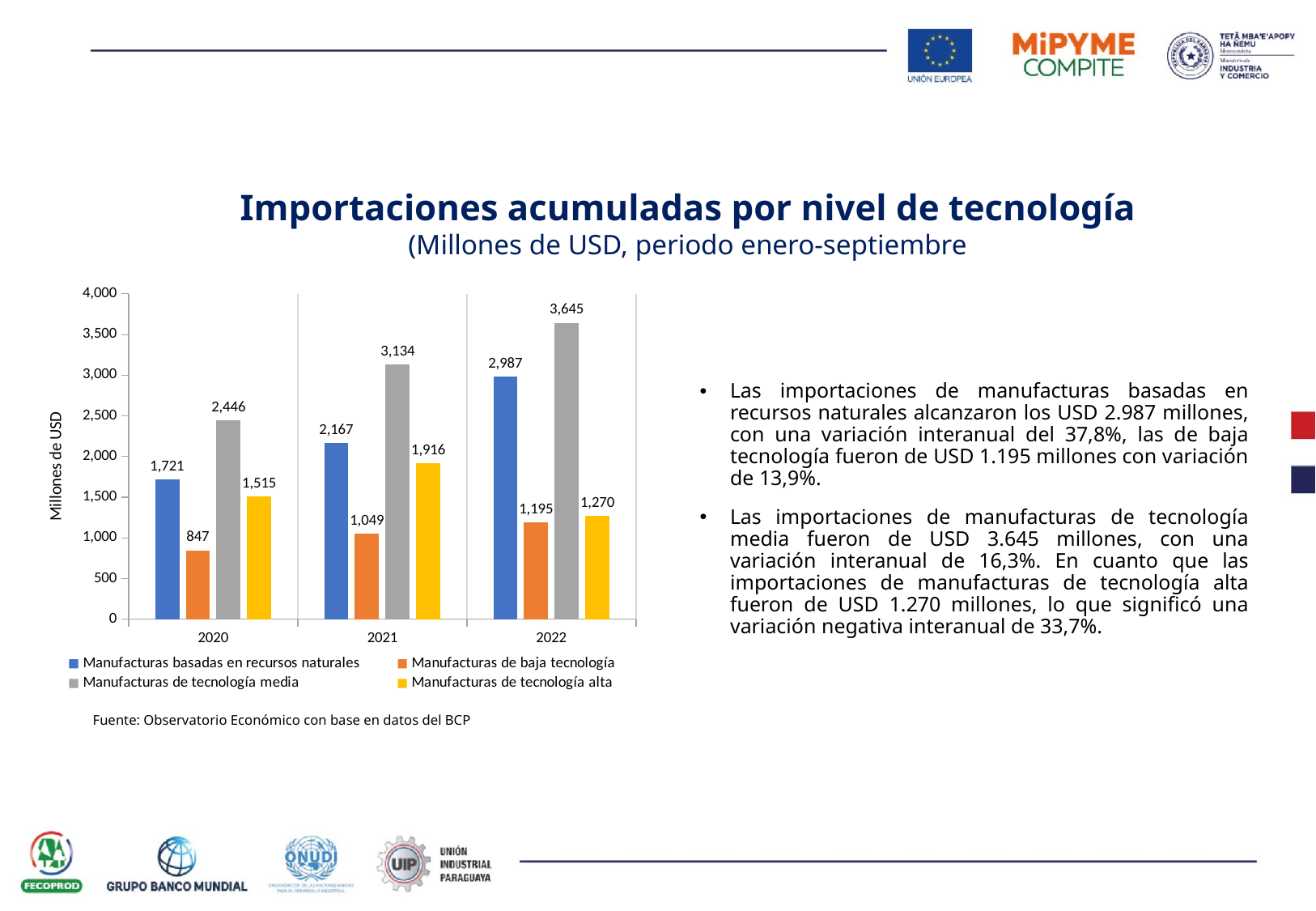
What is the difference between the Manufacturas de tecnología media values in 2022 and 2021? 511 Do the values for Manufacturas basadas en recursos naturales rise or fall from 2020 to 2022? Rise Which is larger in 2022: Manufacturas de tecnología alta or Manufacturas de baja tecnología? Manufacturas de tecnología alta In which year is the value for Manufacturas de tecnología media highest? 2022 What kind of chart is shown on the slide? Bar chart How many series does the legend list? 4 What is the value for Manufacturas de tecnología media in 2022? 3,645 What is the value for Manufacturas basadas en recursos naturales in 2021? 2,167 What is the value for Manufacturas de baja tecnología in 2020? 847 How many years are shown on the x axis? 3 Which series has the lowest value in 2021? Manufacturas de baja tecnología What is the value for Manufacturas de tecnología alta in 2021? 1,916